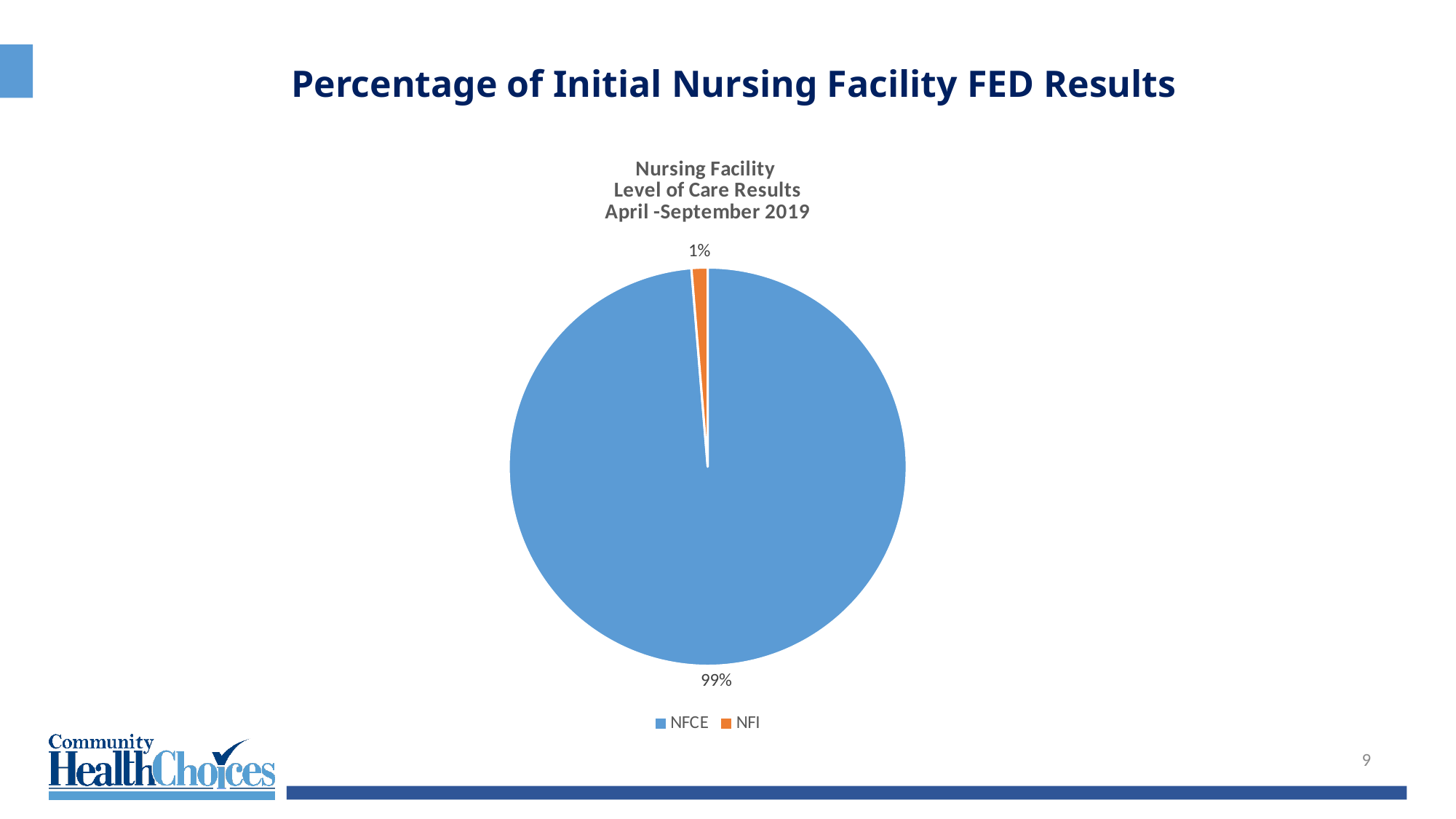
What percentage of the pie does NFCE account for? 99% What colour is the NFI slice? orange Which category has the smallest share of the pie? NFI How many categories does the pie chart show? 2 What kind of chart is shown on the slide? pie chart Which is larger, the NFCE share or the NFI share? NFCE Which category has the largest share of the pie? NFCE How many entries does the legend list? 2 What is the title of the chart? Nursing Facility Level of Care Results April -September 2019 What percentage of the pie does NFI account for? 1% What is the difference in percentage points between the NFCE and NFI shares? 98